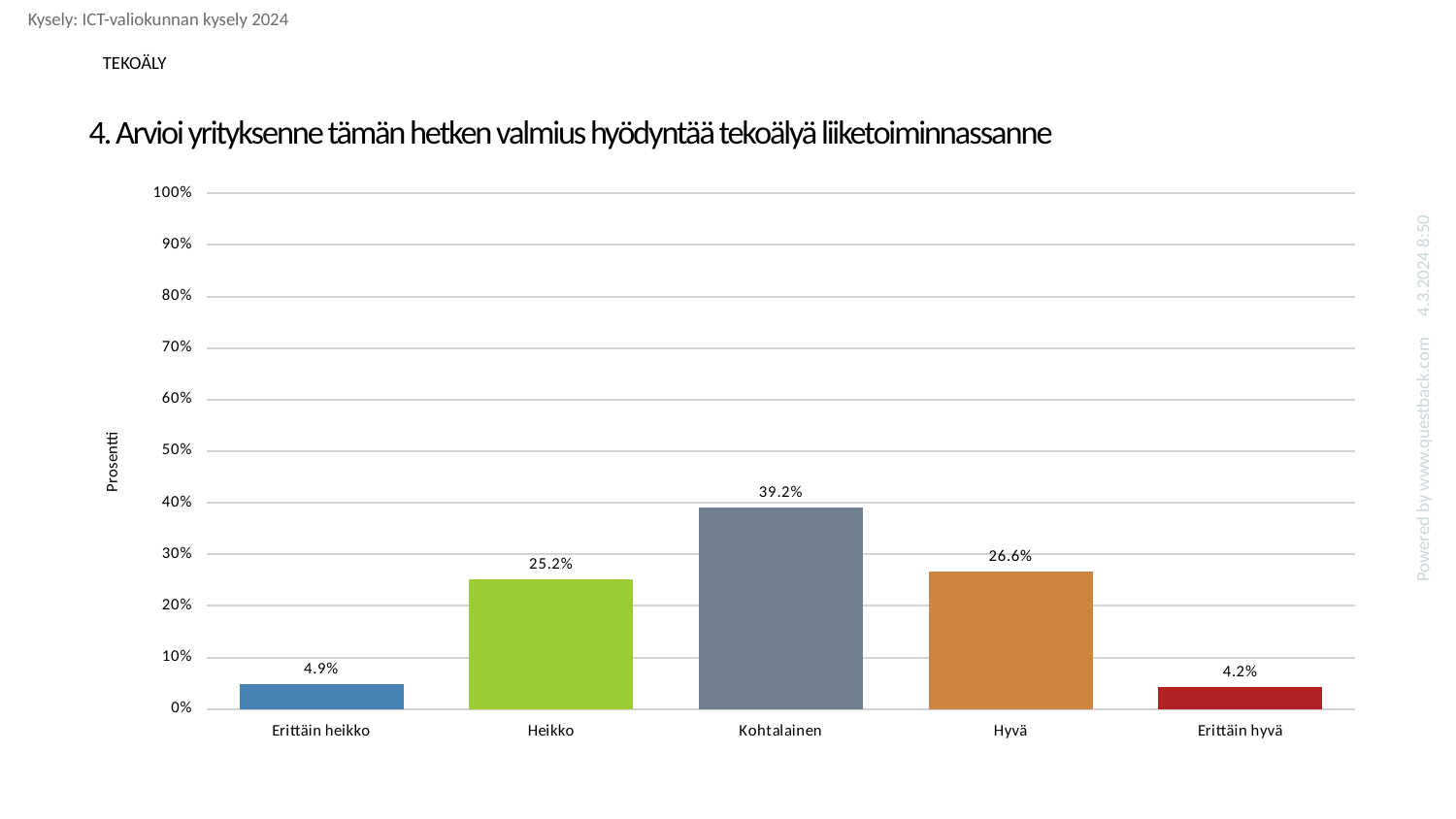
How many categories are shown on the x axis? 5 What is the value for Kohtalainen? 39.2% Which category has the highest value? Kohtalainen What kind of chart is shown on the slide? bar chart Which category has the lowest value? Erittäin hyvä What is the difference between the values for Kohtalainen and Heikko? 14.0% What is the label of the y axis? Prosentti Is the value for Heikko greater or less than 30%? less What is the value for Erittäin heikko? 4.9% What is the difference between the values for Erittäin heikko and Erittäin hyvä? 0.7% Which is larger, the value for Hyvä or the value for Heikko? Hyvä What is the value for Hyvä? 26.6%